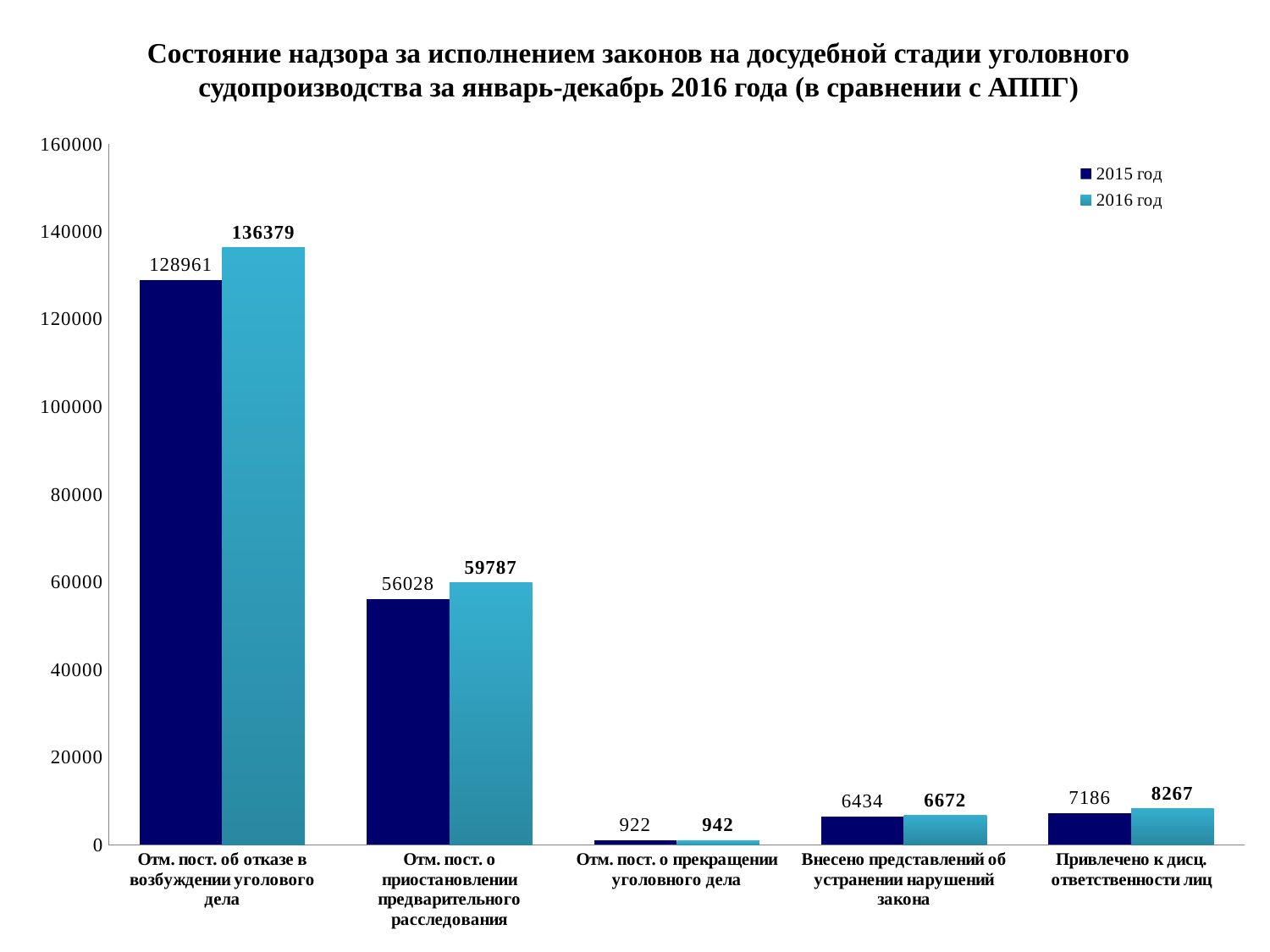
Which is larger for "Отм. пост. о приостановлении предварительного расследования": the 2015 год value or the 2016 год value? 2016 год What is the value for 2015 год in the category "Отм. пост. об отказе в возбуждении уголового дела"? 128961 Which category has the highest value for 2016 год? Отм. пост. об отказе в возбуждении уголового дела What is the value for 2016 год in the category "Привлечено к дисц. ответственности лиц"? 8267 What is the value for 2015 год in the category "Внесено представлений об устранении нарушений закона"? 6434 What is the value for 2016 год in the category "Отм. пост. о приостановлении предварительного расследования"? 59787 What is the difference between the 2016 год and 2015 год values for "Привлечено к дисц. ответственности лиц"? 1081 How many series does the legend list? 2 What kind of chart is shown on the slide? Bar chart What is the difference between the 2016 год and 2015 год values for "Отм. пост. об отказе в возбуждении уголового дела"? 7418 How many categories are shown on the x axis? 5 Which category has the lowest value for 2015 год? Отм. пост. о прекращении уголовного дела